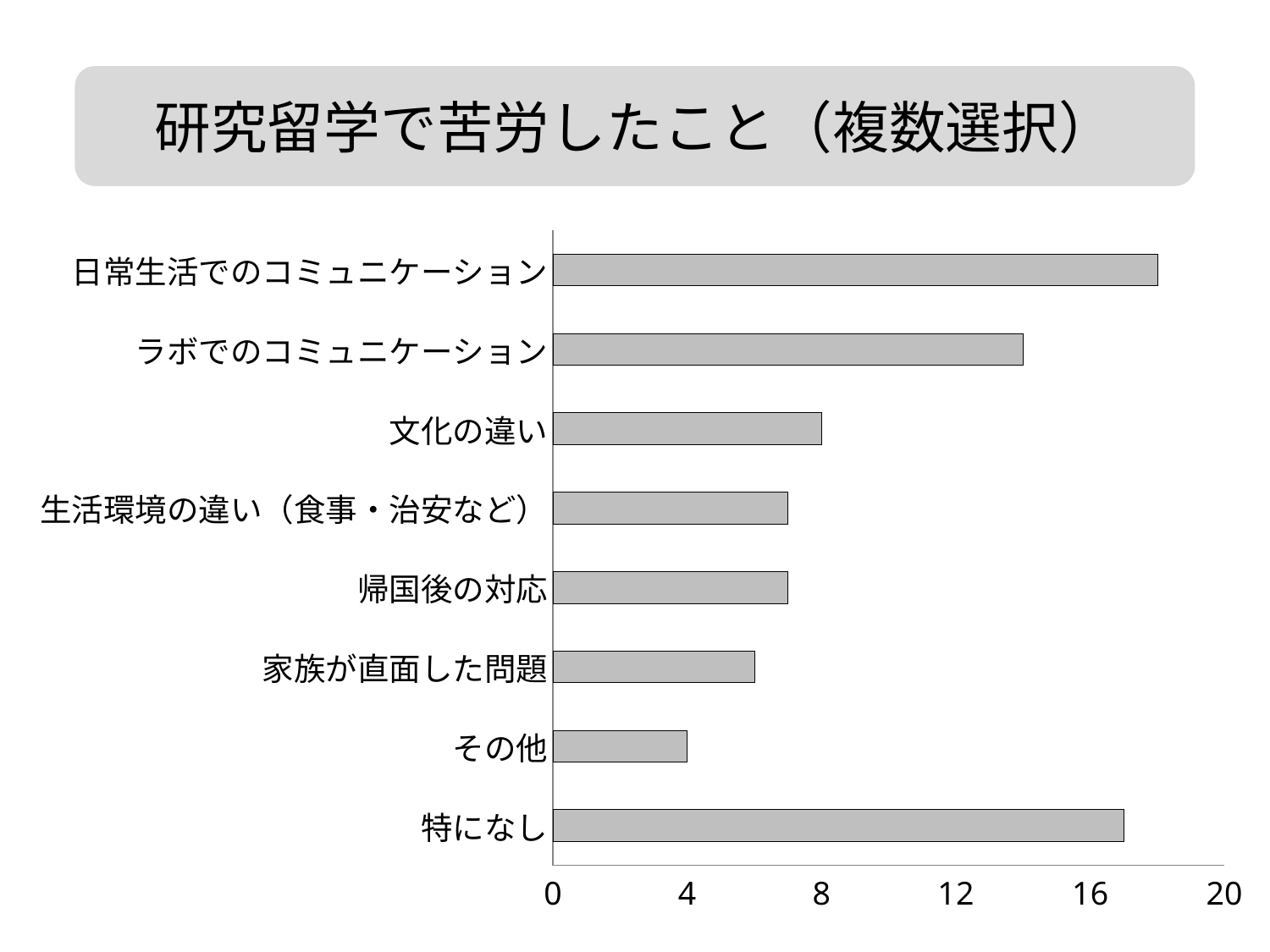
Which category has the highest value? 日常生活でのコミュニケーション How many categories are plotted in the chart? 8 Which category has the lowest value? その他 What kind of chart is shown on the slide? bar chart Which is larger, the value for 文化の違い or the value for 家族が直面した問題? 文化の違い Is the value for 家族が直面した問題 greater or less than 4? greater What is the title of the chart? 研究留学で苦労したこと（複数選択） Which is larger, the value for ラボでのコミュニケーション or the value for 特になし? 特になし What is the value for その他? 4 What is the value for 文化の違い? 8 Is the value for ラボでのコミュニケーション greater or less than 12? greater Is the value for 日常生活でのコミュニケーション greater or less than 16? greater